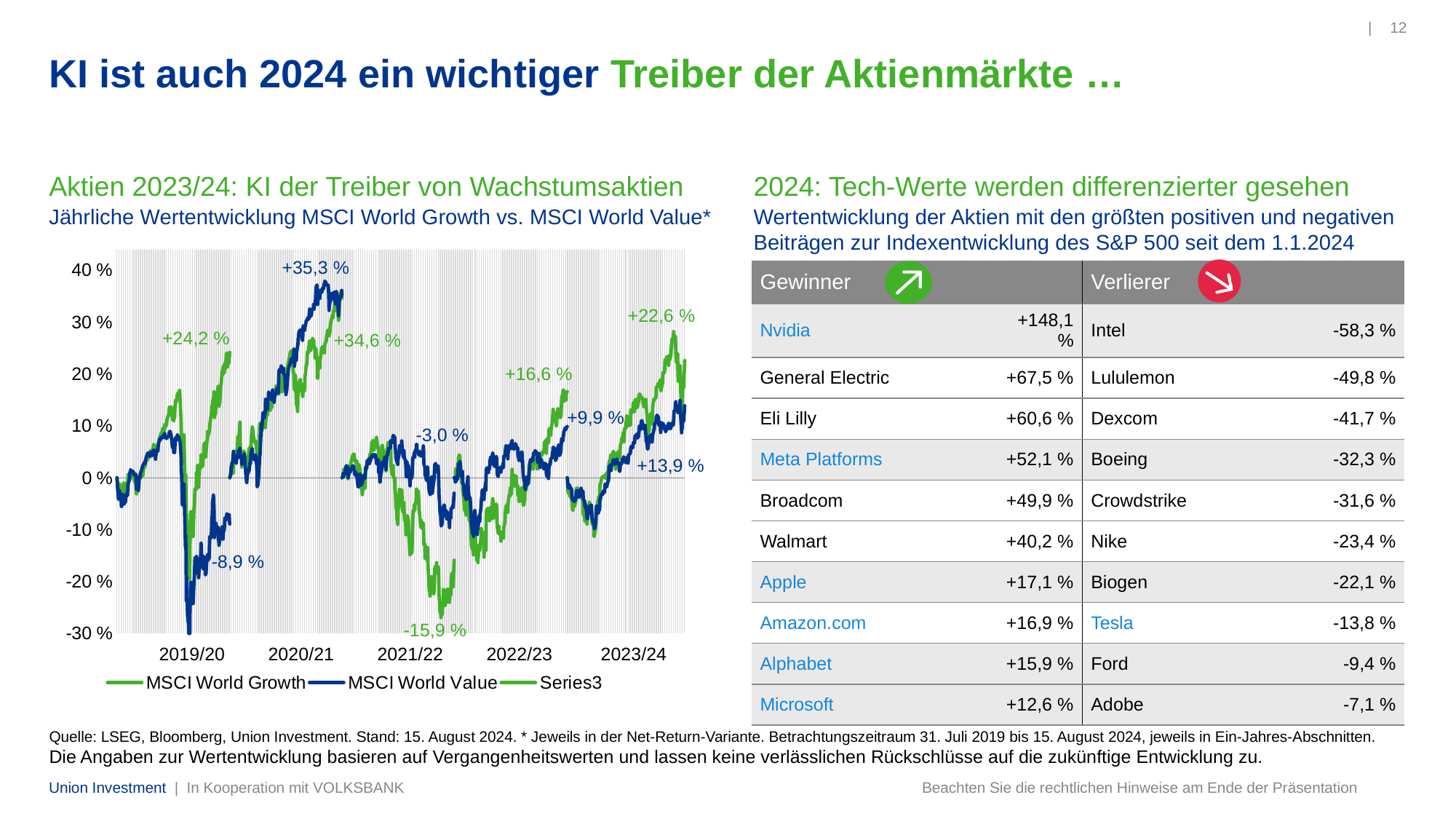
What is the labelled annual performance of MSCI World Growth for 2023/24? +22,6 % In 2023/24, which series has the higher labelled performance, MSCI World Growth or MSCI World Value? MSCI World Growth What is the difference in percentage points between the labelled 2023/24 values of MSCI World Growth (+22,6 %) and MSCI World Value (+13,9 %)? 8,7 percentage points What is the labelled annual performance of MSCI World Value for 2019/20? -8,9 % In which period does MSCI World Growth have its highest labelled annual performance? 2020/21 In 2020/21, which series has the higher labelled performance, MSCI World Growth or MSCI World Value? MSCI World Value What is the labelled annual performance of MSCI World Growth for 2021/22? -15,9 % What is the labelled annual performance of MSCI World Value for 2020/21? +35,3 % What is the difference in percentage points between the labelled 2022/23 values of MSCI World Growth (+16,6 %) and MSCI World Value (+9,9 %)? 6,7 percentage points How many entries does the legend of the line chart list? 3 What kind of chart is shown on the left of the slide? line chart In which period does MSCI World Value have its lowest labelled annual performance? 2019/20